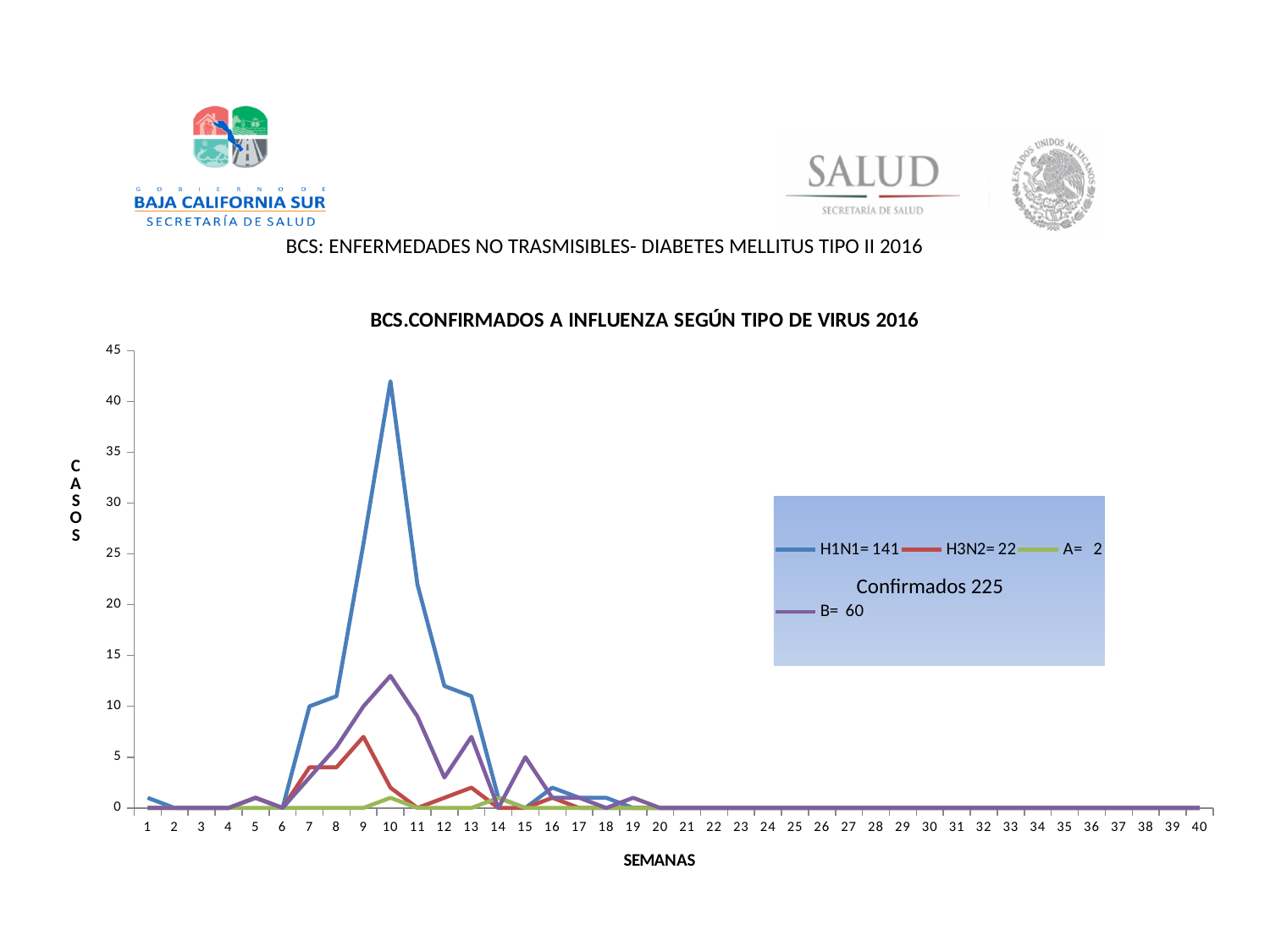
According to the legend, what is the total number of H1N1 cases? 141 Which virus type has the highest total number of cases? H1N1 According to the legend, what is the total number of H3N2 cases? 22 In which week does the H1N1 line reach its peak? 10 According to the legend, what is the total number of B cases? 60 How many series does the legend list? 4 What is the total number of confirmed cases (Confirmados) shown in the legend? 225 Is the H1N1 value in week 10 greater or less than 40? greater How many weeks (semanas) are shown on the x axis? 40 What type of chart is shown on the slide? line chart Which virus type has the lowest total number of cases? A What is the difference between the H1N1 total and the H3N2 total? 119